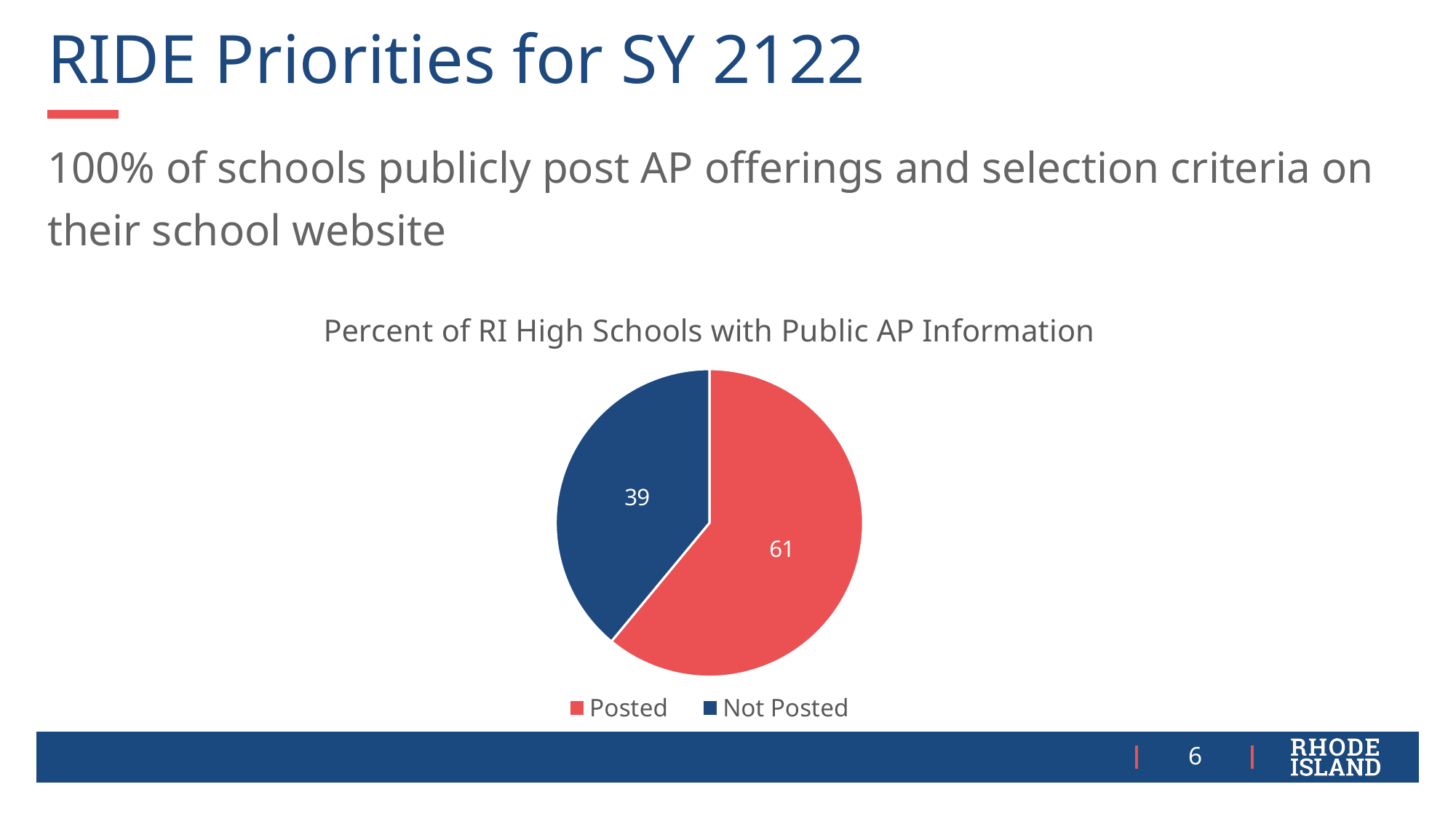
How many slices does the pie chart have? 2 What value is shown for the Not Posted slice? 39 What is the total of the two slice values? 100 What value is shown for the Posted slice? 61 Which slice is the largest? Posted How many entries does the legend list? 2 What colour is the Not Posted slice? Blue What kind of chart is shown on the slide? Pie chart What is the title of the chart? Percent of RI High Schools with Public AP Information Which slice is the smallest? Not Posted What is the difference between the Posted and Not Posted values? 22 Which is larger, Posted or Not Posted? Posted